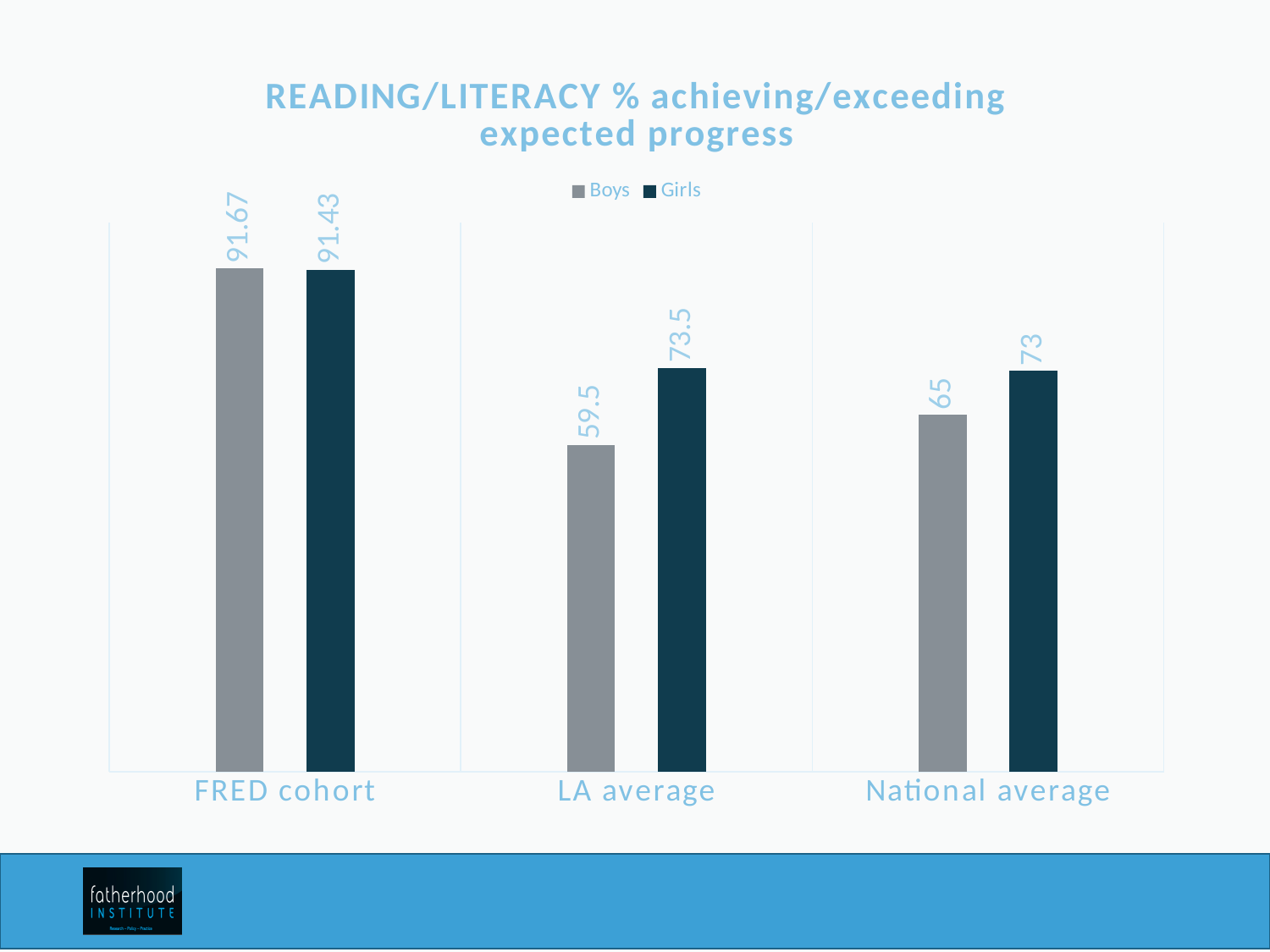
What is the value for Boys in the FRED cohort? 91.67 Which category has the lowest value for Boys? LA average What is the difference between the Boys values for the FRED cohort and the National average? 26.67 How many categories are shown on the x axis? 3 What is the value for Girls in the LA average? 73.5 What is the value for Boys in the National average? 65 Which is larger in the National average, the Boys value or the Girls value? Girls What kind of chart is shown on the slide? Bar chart Which category has the highest value for Girls? FRED cohort What is the difference between the Girls and Boys values in the LA average? 14 How many series does the legend list? 2 What is the value for Girls in the National average? 73